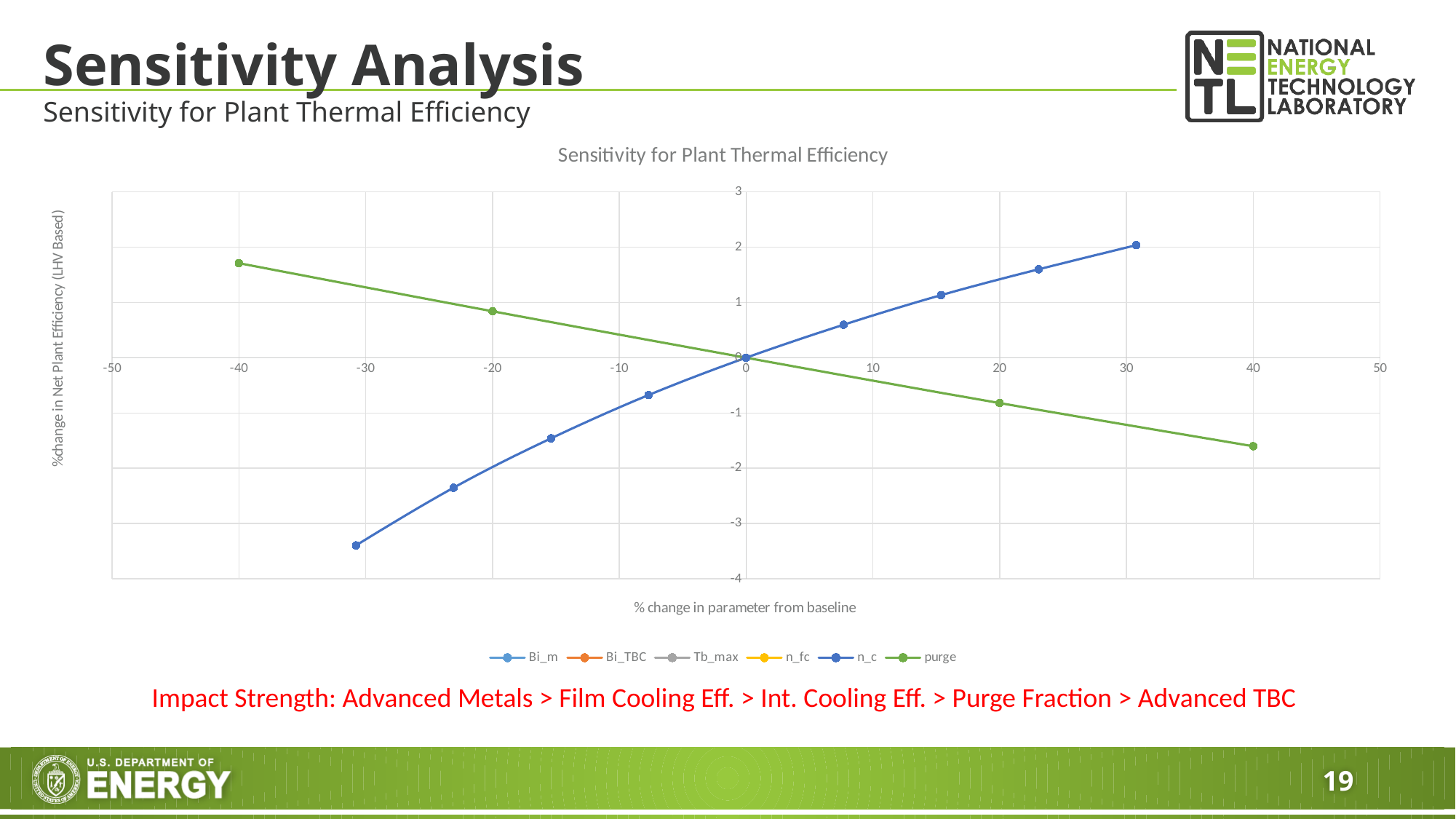
Is the value of the purge series at 40 greater or less than -1? less Which plotted series reaches the lowest value on the chart, n_c or purge? n_c Does the n_c series rise or fall as the % change in parameter increases along the x axis? rise Is the value of the purge series at 20 greater or less than -1? greater How many data points are plotted for the purge series? 5 Is the value of the purge series at -40 greater or less than 1? greater What kind of chart is shown on the slide? line chart How many data points are plotted for the n_c series? 9 What is the x-axis title of the chart? % change in parameter from baseline What is the title of the chart? Sensitivity for Plant Thermal Efficiency Does the purge series rise or fall as the % change in parameter increases along the x axis? fall How many series does the legend list? 6